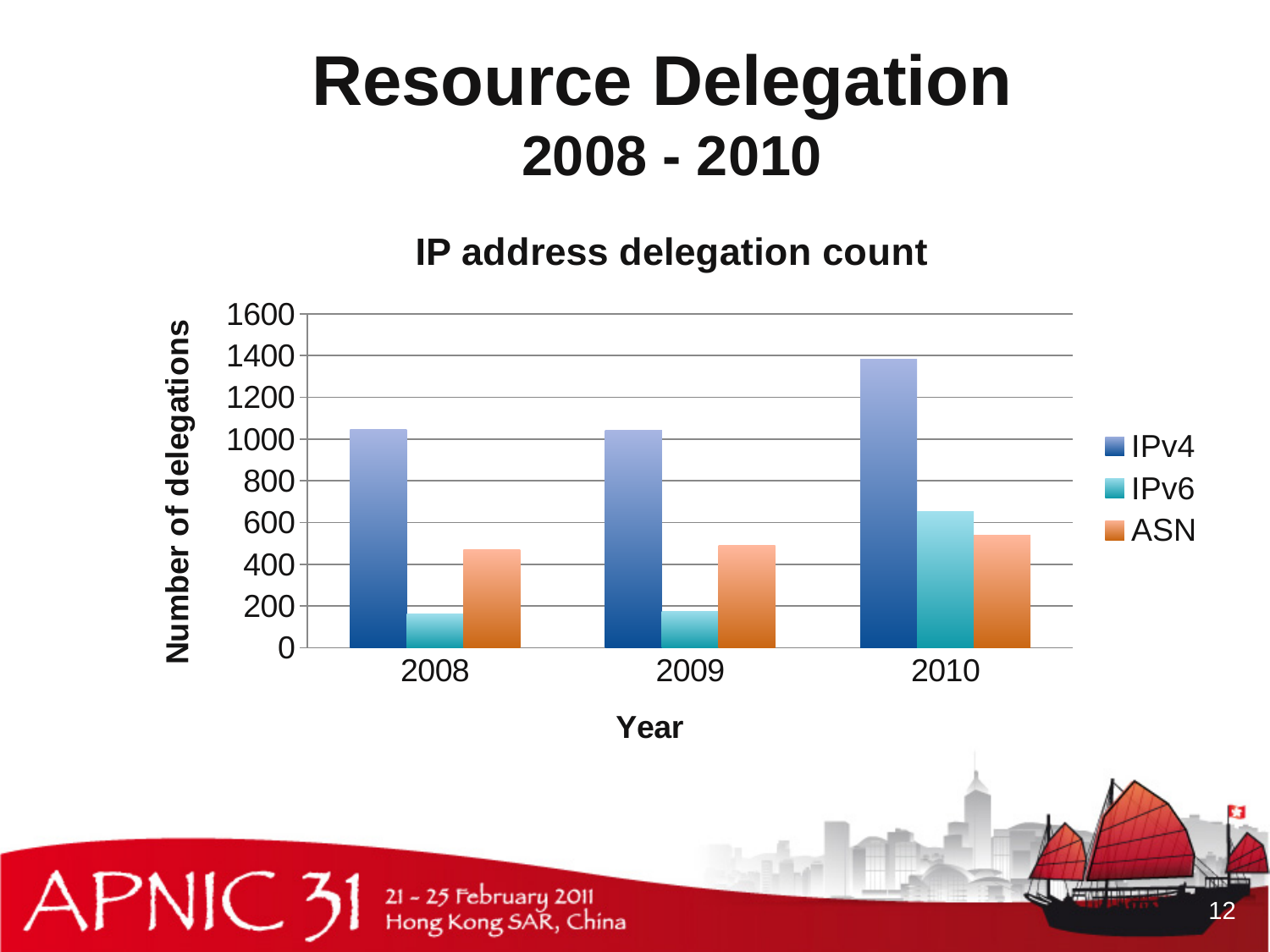
Is the ASN value for 2010 greater or less than 600? less What kind of chart is shown on the slide? bar chart In which year is the IPv6 delegation count highest? 2010 How many years are shown on the x axis? 3 Does the ASN delegation count rise or fall from 2008 to 2010? rise What is the title of the chart? IP address delegation count In which year is the IPv4 delegation count highest? 2010 Is the IPv6 value for 2008 greater or less than 200? less Which is larger in 2009, the ASN count or the IPv6 count? ASN How many series does the legend list? 3 Is the IPv6 value for 2010 greater or less than 600? greater